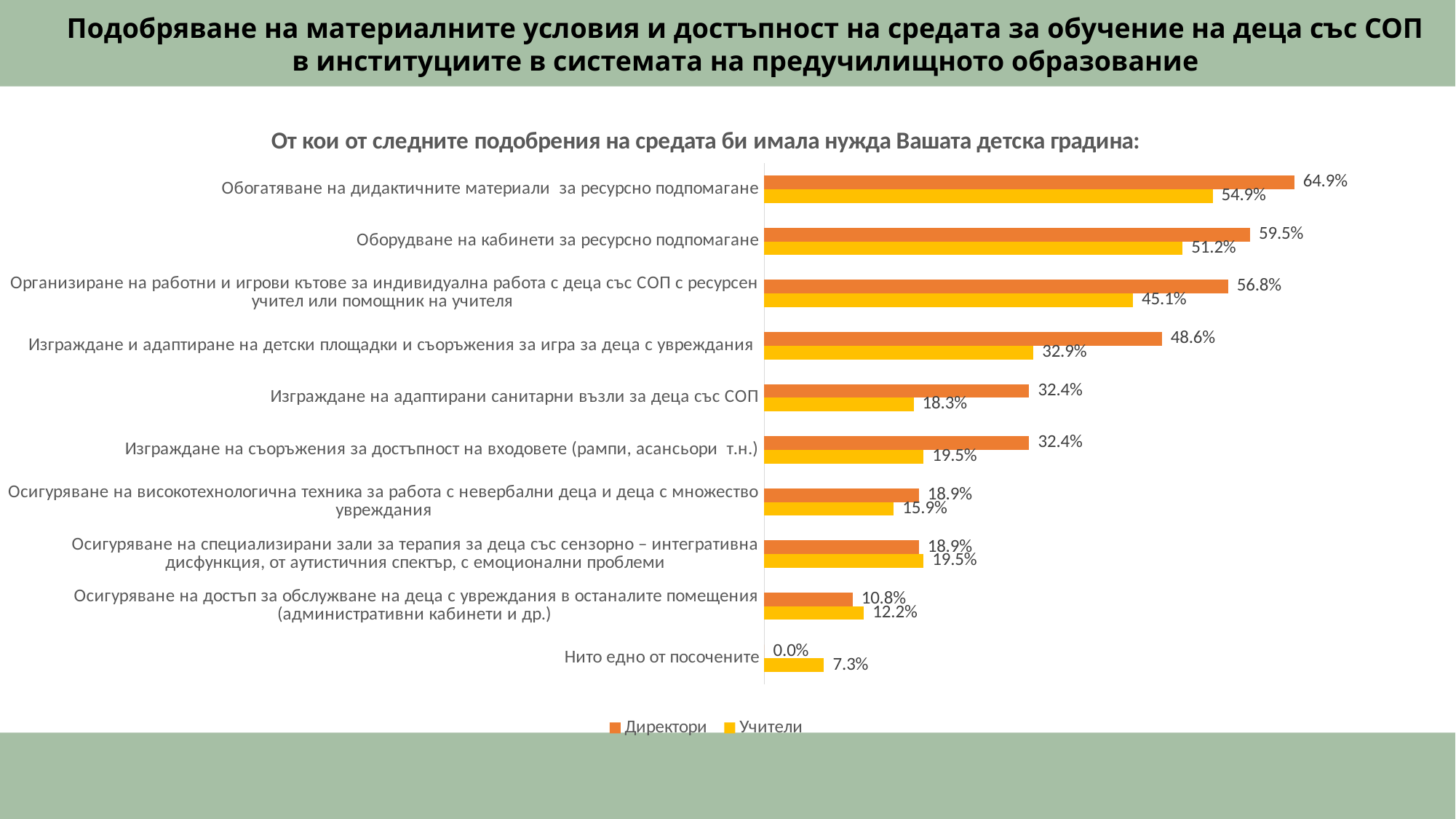
What value do Учители give for 'Нито едно от посочените'? 7.3% How many series does the legend list? 2 How many categories are shown in the chart? 10 What is the difference between the Директори and Учители values for 'Оборудване на кабинети за ресурсно подпомагане'? 8.3% What is the difference between the Директори and Учители values for 'Изграждане на адаптирани санитарни възли за деца със СОП'? 14.1% Which category has the highest value for Директори? Обогатяване на дидактичните материали за ресурсно подпомагане What type of chart is shown on the slide? Bar chart What value do Учители give for 'Изграждане и адаптиране на детски площадки и съоръжения за игра за деца с увреждания'? 32.9% What value do Директори give for 'Обогатяване на дидактичните материали за ресурсно подпомагане'? 64.9% For 'Осигуряване на достъп за обслужване на деца с увреждания в останалите помещения (административни кабинети и др.)', which group has the larger value, Директори or Учители? Учители Which category has the lowest value for Учители? Нито едно от посочените Which colour represents the Учители series? Yellow